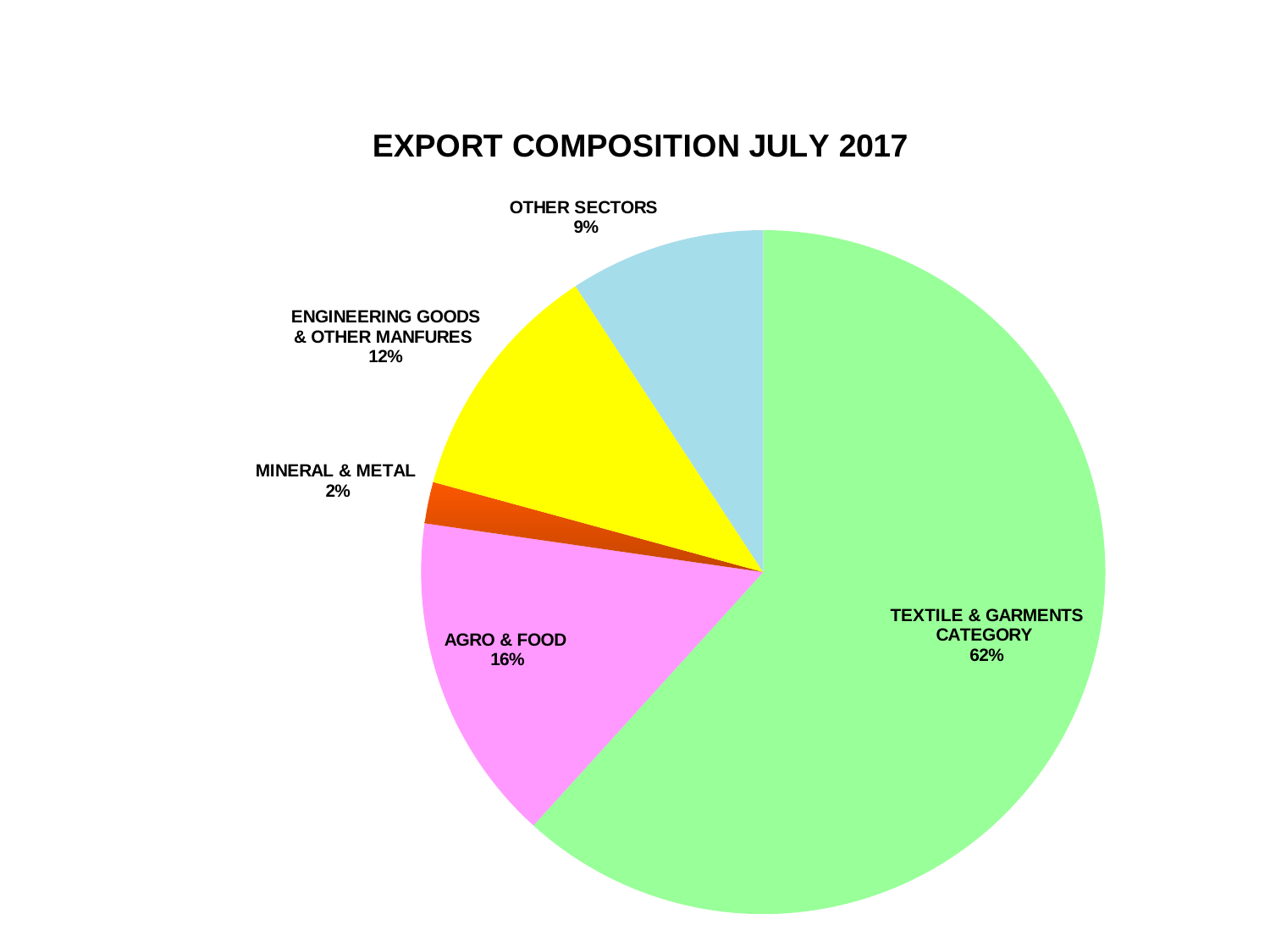
Which is larger, the share for ENGINEERING GOODS & OTHER MANFURES or the share for OTHER SECTORS? ENGINEERING GOODS & OTHER MANFURES What is the difference between the shares of AGRO & FOOD and OTHER SECTORS? 7% What share of exports does the TEXTILE & GARMENTS CATEGORY account for? 62% What is the value shown for AGRO & FOOD? 16% How many categories are shown in the pie chart? 5 What is the title of the chart? EXPORT COMPOSITION JULY 2017 Which category has the largest share of the pie? TEXTILE & GARMENTS CATEGORY Which category has the smallest share of the pie? MINERAL & METAL What kind of chart is shown on the slide? pie chart What is the value shown for ENGINEERING GOODS & OTHER MANFURES? 12% What is the value shown for OTHER SECTORS? 9% What is the value shown for MINERAL & METAL? 2%